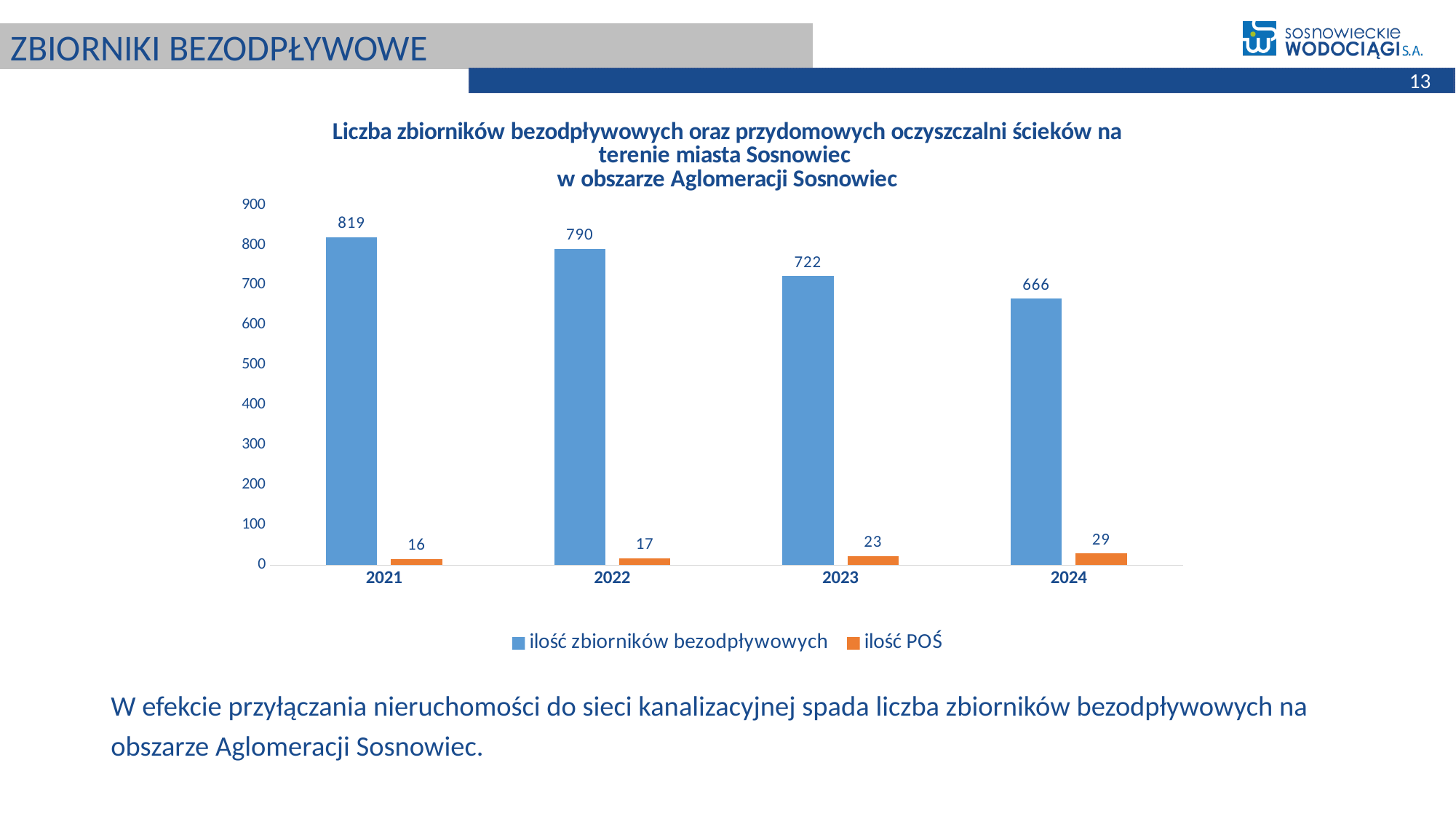
What is the difference between 'ilość POŚ' in 2023 and in 2022? 6 In which year is 'ilość zbiorników bezodpływowych' the lowest? 2024 What kind of chart is shown on the slide? bar chart How many years are shown on the x axis? 4 How many series does the legend list? 2 What is the value of 'ilość zbiorników bezodpływowych' for 2023? 722 Which is larger: 'ilość zbiorników bezodpływowych' in 2022 or in 2023? 2022 In which year is 'ilość POŚ' the highest? 2024 What is the difference between 'ilość zbiorników bezodpływowych' in 2021 and in 2024? 153 Does 'ilość zbiorników bezodpływowych' rise or fall from 2021 to 2024? fall What is the value of 'ilość POŚ' for 2024? 29 What is the value of 'ilość zbiorników bezodpływowych' for 2021? 819